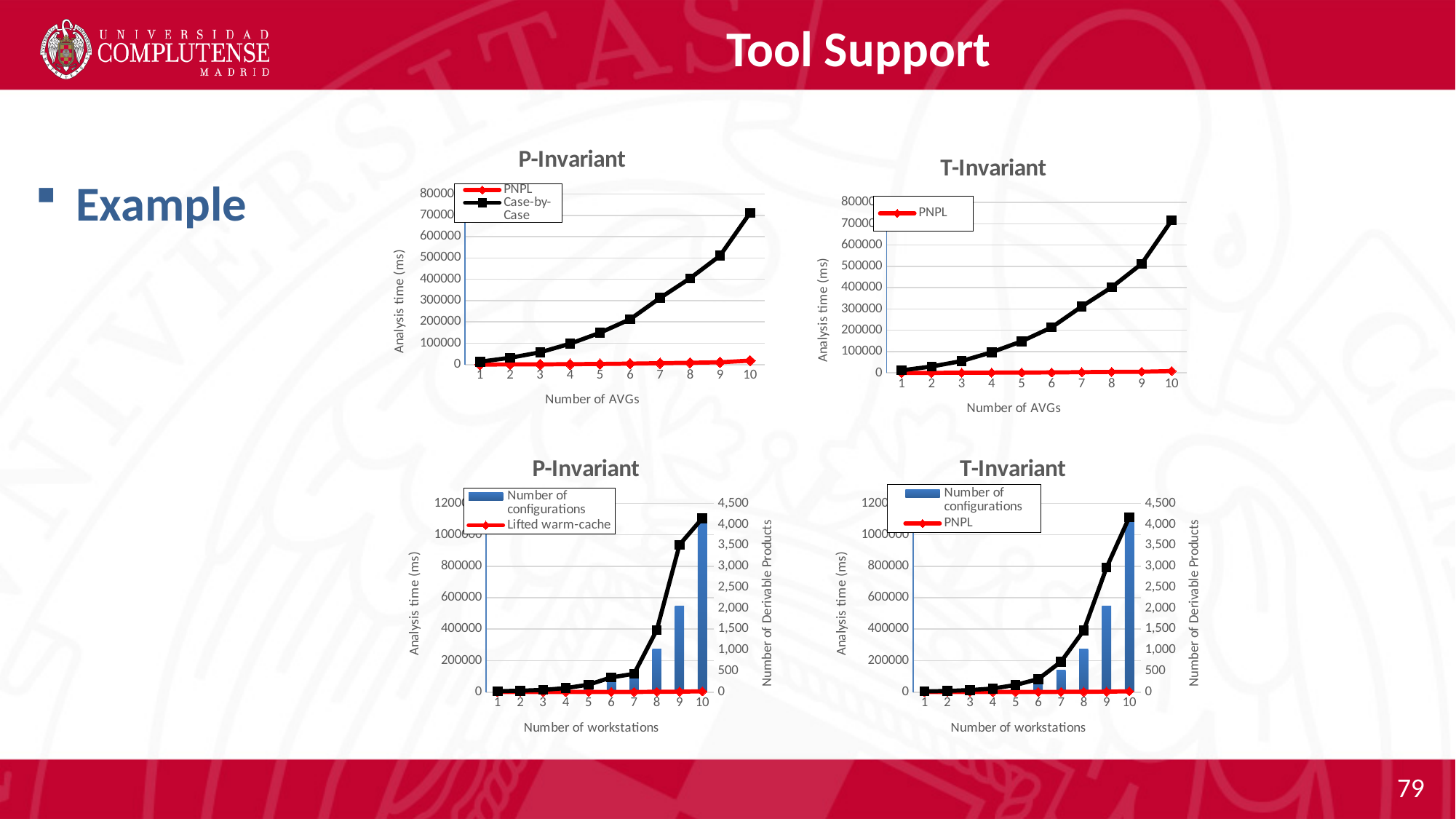
In the top-left P-Invariant chart, is the Case-by-Case value at 10 AVGs greater or less than 600000? greater In the bottom-right T-Invariant chart, is the black-line analysis time at 10 workstations greater or less than 1000000? greater In the top-right T-Invariant chart, is the black-line value at 10 AVGs greater or less than 600000? greater How many series does the legend of the top-left P-Invariant chart list? 2 In the top-left P-Invariant chart, does the Case-by-Case analysis time rise or fall as the number of AVGs increases? rise In the top-left P-Invariant chart, how many points along the Number of AVGs axis are plotted for each series? 10 What is the label of the x axis of the bottom-left P-Invariant chart? Number of workstations In the top-left P-Invariant chart, which series has the larger value at 10 AVGs, PNPL or Case-by-Case? Case-by-Case What kind of chart is the top-left P-Invariant chart? line chart How many series does the legend of the top-right T-Invariant chart list? 1